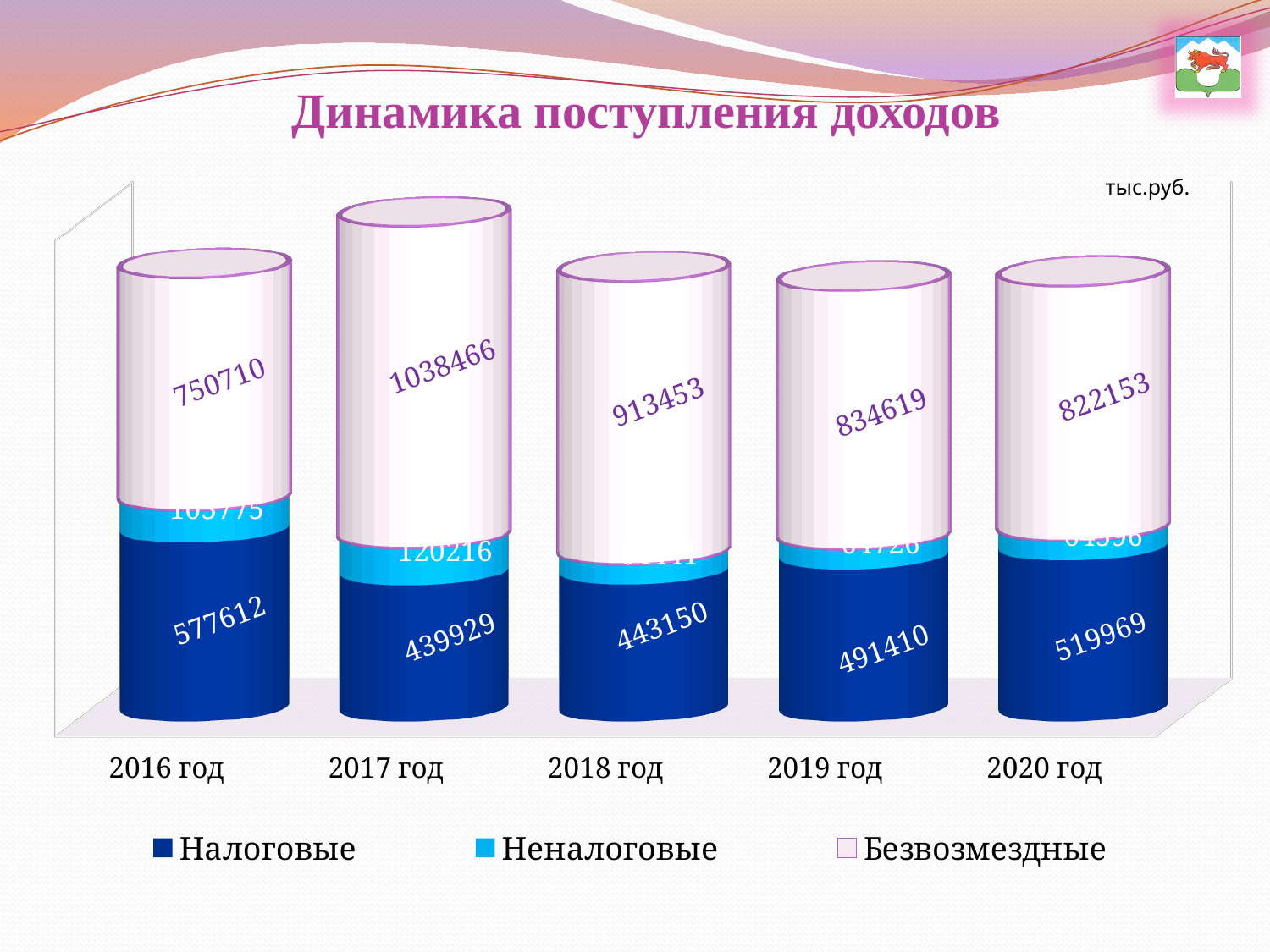
What is the total of the stacked bar for 2017 год? 1598611 What is the difference between the Безвозмездные values for 2017 год and 2016 год? 287756 What kind of chart is shown on the slide? Stacked bar chart In which year is the Налоговые value the lowest? 2017 год What is the difference between the Налоговые values for 2016 год and 2020 год? 57643 What is the value of Неналоговые for 2017 год? 120216 How many series does the legend list? 3 What is the value of Безвозмездные for 2017 год? 1038466 What is the value of Налоговые for 2016 год? 577612 How many years are shown on the x axis? 5 Which year has the larger Безвозмездные value, 2018 год or 2019 год? 2018 год In which year is the Безвозмездные value the highest? 2017 год